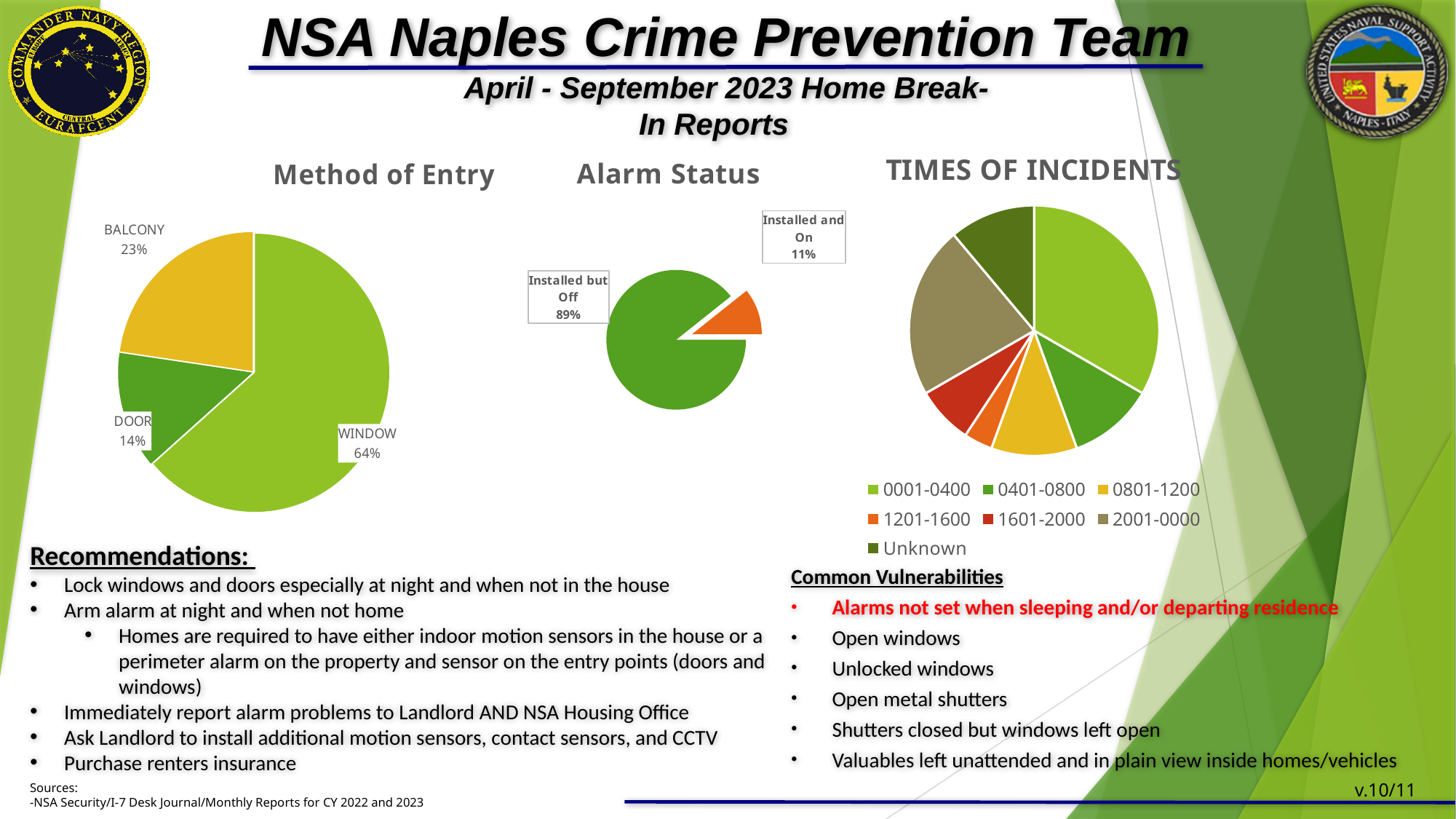
In the Method of Entry chart, which method of entry has the smallest share? DOOR In the Method of Entry chart, how many categories are shown? 3 In the Alarm Status chart, what percentage of alarms were installed but off? 89% In the Method of Entry chart, what share of break-ins used the window? 64% In the Method of Entry chart, which method of entry has the largest share? WINDOW In the Alarm Status chart, which is larger: Installed but Off or Installed and On? Installed but Off In the Method of Entry chart, what is the difference in percentage points between Window and Balcony? 41 In the Method of Entry chart, what percentage is shown for Balcony? 23% How many time categories does the legend of the Times of Incidents chart list? 7 In the Alarm Status chart, what percentage of alarms were installed and on? 11% What kind of chart is the Times of Incidents chart? Pie chart In the Times of Incidents chart, which time slot has the largest slice? 0001-0400